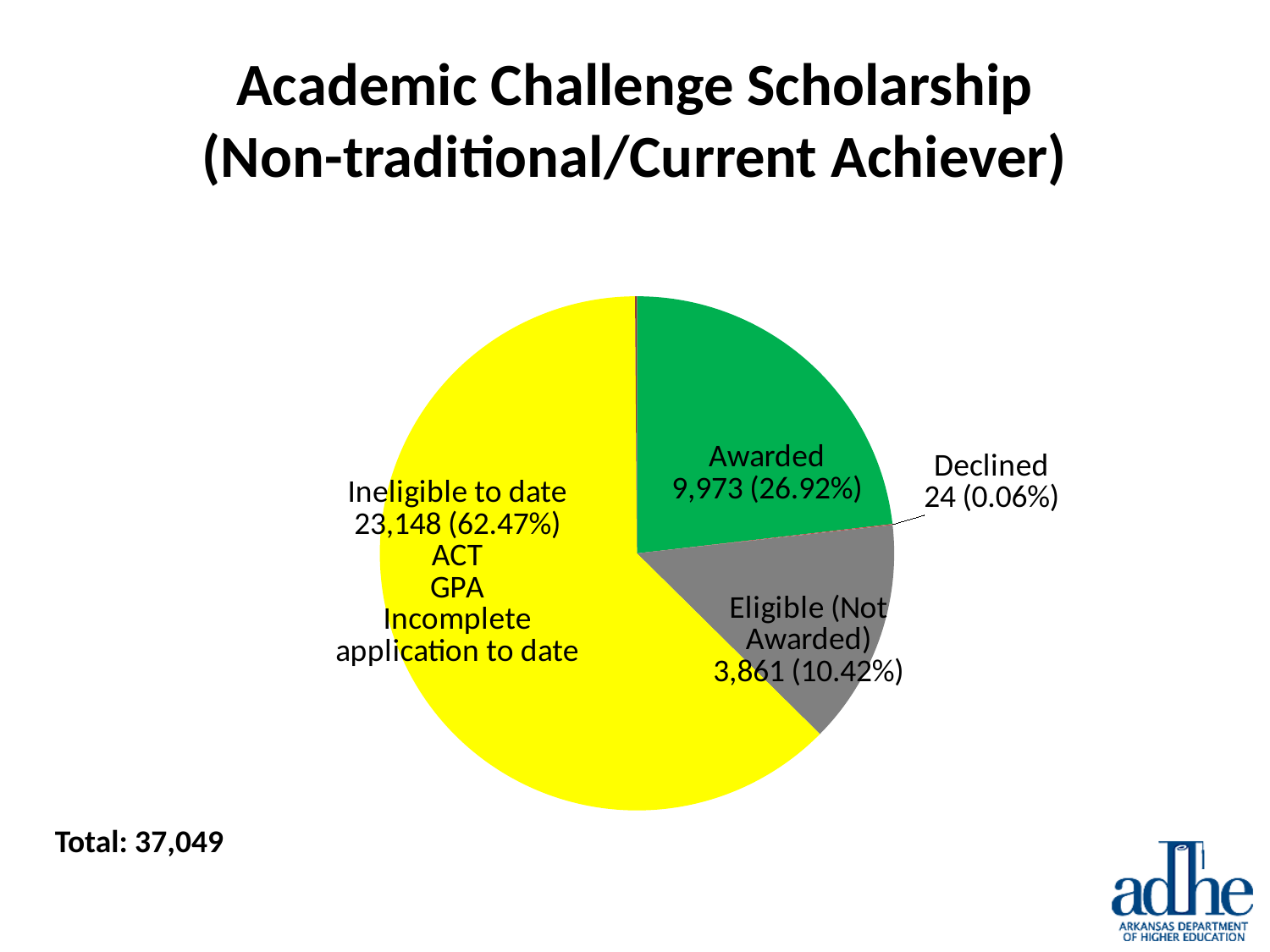
What share of the pie does the Eligible (Not Awarded) slice represent? 10.42% What is the value for the Ineligible to date slice? 23,148 What is the value for the Declined slice? 24 What share of the pie does the Awarded slice represent? 26.92% Which is larger, the Awarded value or the Eligible (Not Awarded) value? Awarded What is the value for the Awarded slice? 9,973 Which slice is the smallest? Declined Which slice is the largest? Ineligible to date What is the value for the Eligible (Not Awarded) slice? 3,861 What kind of chart is shown on the slide? pie chart What is the difference between the Awarded and Eligible (Not Awarded) values? 6,112